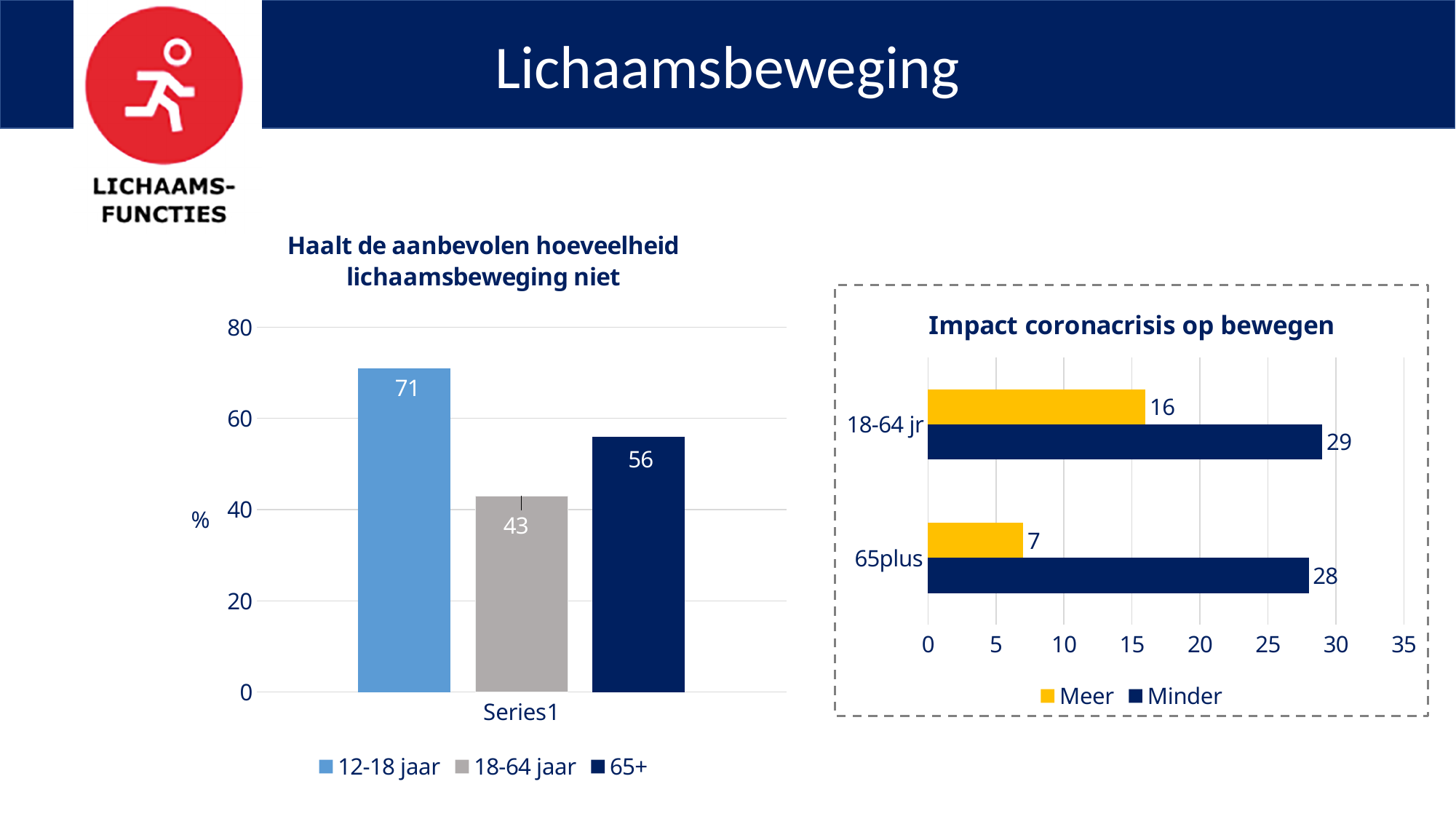
In the chart 'Impact coronacrisis op bewegen', what is the difference between the Minder and Meer values for 65plus? 21 In the chart 'Haalt de aanbevolen hoeveelheid lichaamsbeweging niet', what is the value for 12-18 jaar? 71 In the chart 'Impact coronacrisis op bewegen', what is the Minder value for 65plus? 28 In the chart 'Haalt de aanbevolen hoeveelheid lichaamsbeweging niet', what is the value for 65+? 56 In the chart 'Haalt de aanbevolen hoeveelheid lichaamsbeweging niet', which group has the lowest value? 18-64 jaar In the chart 'Haalt de aanbevolen hoeveelheid lichaamsbeweging niet', which group has the highest value? 12-18 jaar In the chart 'Haalt de aanbevolen hoeveelheid lichaamsbeweging niet', how many series does the legend list? 3 In the chart 'Impact coronacrisis op bewegen', what colour represents the Meer series? Yellow In the chart 'Haalt de aanbevolen hoeveelheid lichaamsbeweging niet', what is the difference between the values for 12-18 jaar and 18-64 jaar? 28 What kind of chart is 'Impact coronacrisis op bewegen'? Bar chart In the chart 'Impact coronacrisis op bewegen', what is the Meer value for 18-64 jr? 16 In the chart 'Impact coronacrisis op bewegen', which is larger for 18-64 jr: Meer or Minder? Minder